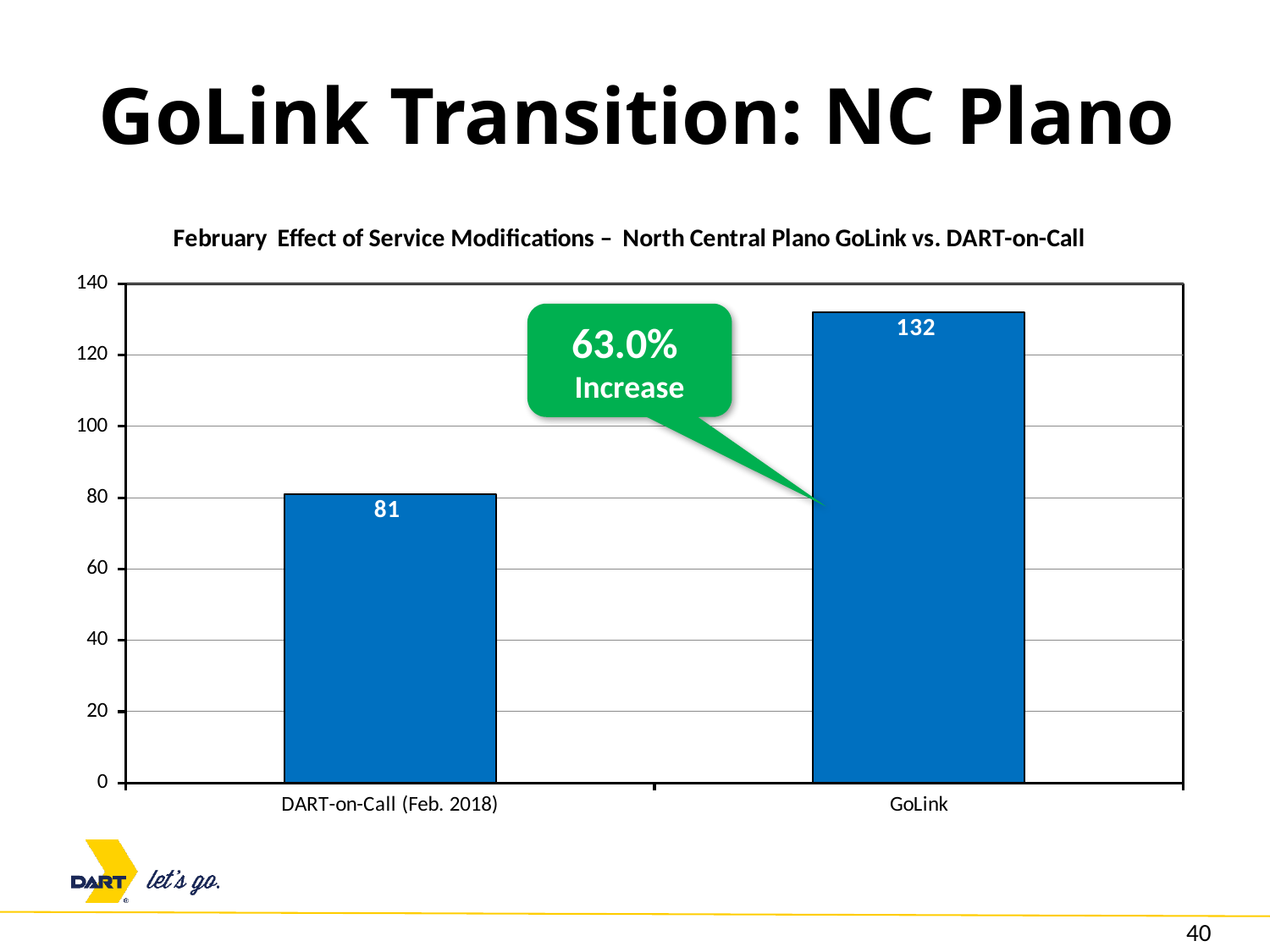
Which category has the lowest value? DART-on-Call (Feb. 2018) Is the value for GoLink greater or less than 120? greater What kind of chart is shown on the slide? Bar chart Which is larger, the value for GoLink or the value for DART-on-Call (Feb. 2018)? GoLink How many categories are shown on the x axis? 2 What is the value for DART-on-Call (Feb. 2018)? 81 Is the value for DART-on-Call (Feb. 2018) greater or less than 100? less What is the value for GoLink? 132 What percentage increase does the callout on the chart state? 63.0% What is the difference between the GoLink value and the DART-on-Call (Feb. 2018) value? 51 Which category has the highest value? GoLink What is the title of the chart? February Effect of Service Modifications – North Central Plano GoLink vs. DART-on-Call